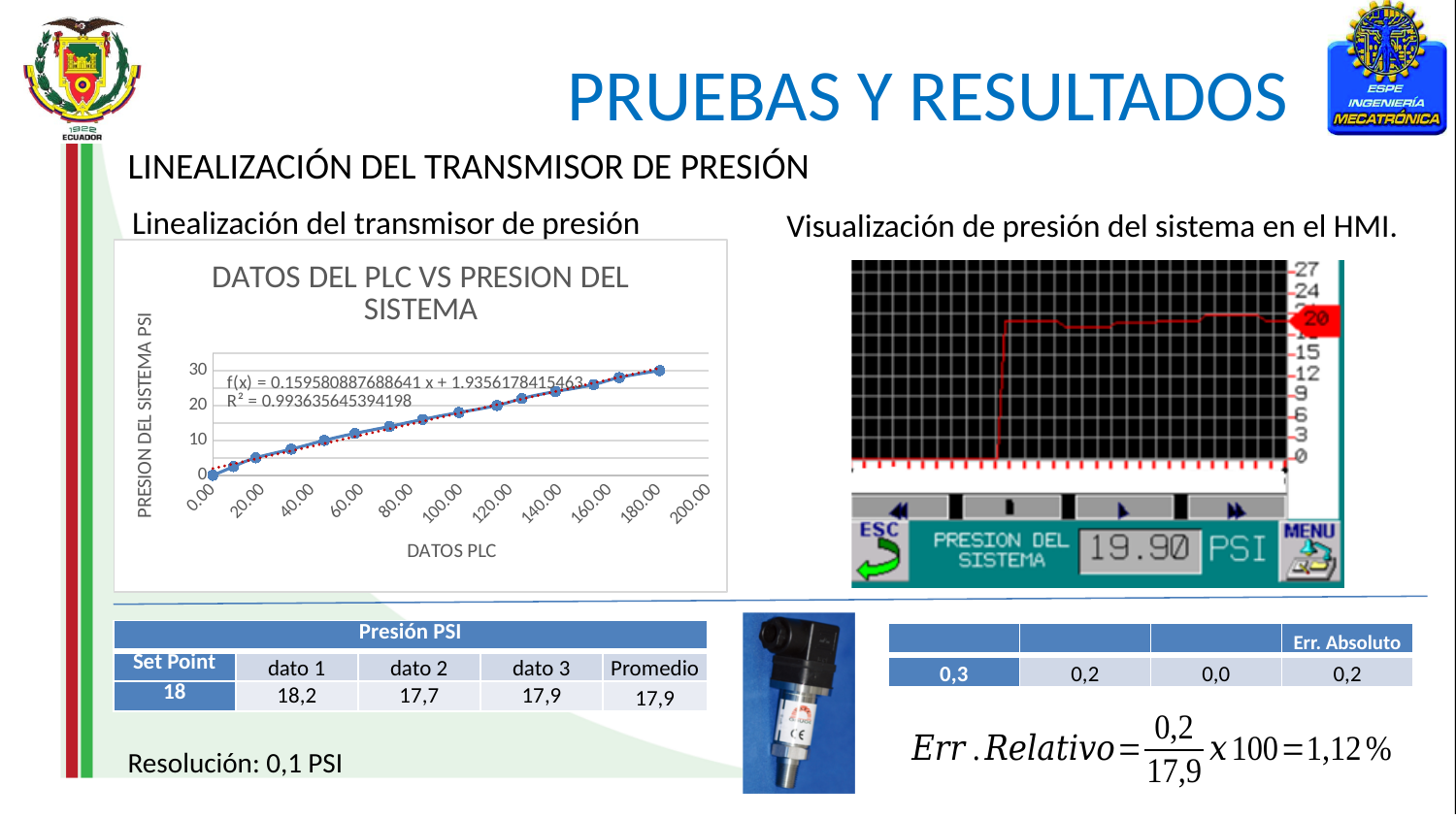
In the chart titled DATOS DEL PLC VS PRESION DEL SISTEMA, do the values rise or fall as DATOS PLC increases? rise In the chart titled DATOS DEL PLC VS PRESION DEL SISTEMA, what is the highest tick value shown on the y axis? 30 In the chart titled DATOS DEL PLC VS PRESION DEL SISTEMA, is the pressure value at DATOS PLC = 180.00 greater or less than 20? greater In the chart titled DATOS DEL PLC VS PRESION DEL SISTEMA, is the pressure value at DATOS PLC = 100.00 greater or less than 10? greater In the chart titled DATOS DEL PLC VS PRESION DEL SISTEMA, is the pressure value at DATOS PLC = 140.00 greater or less than 30? less In the chart titled DATOS DEL PLC VS PRESION DEL SISTEMA, what kind of chart is shown? scatter chart In the chart titled DATOS DEL PLC VS PRESION DEL SISTEMA, what is the highest tick value shown on the x axis? 200.00 In the chart titled DATOS DEL PLC VS PRESION DEL SISTEMA, what R² value is printed for the trendline? 0.993635645394198 In the chart titled DATOS DEL PLC VS PRESION DEL SISTEMA, what is the label of the x axis? DATOS PLC What is the title of the chart on the left side of the slide? DATOS DEL PLC VS PRESION DEL SISTEMA